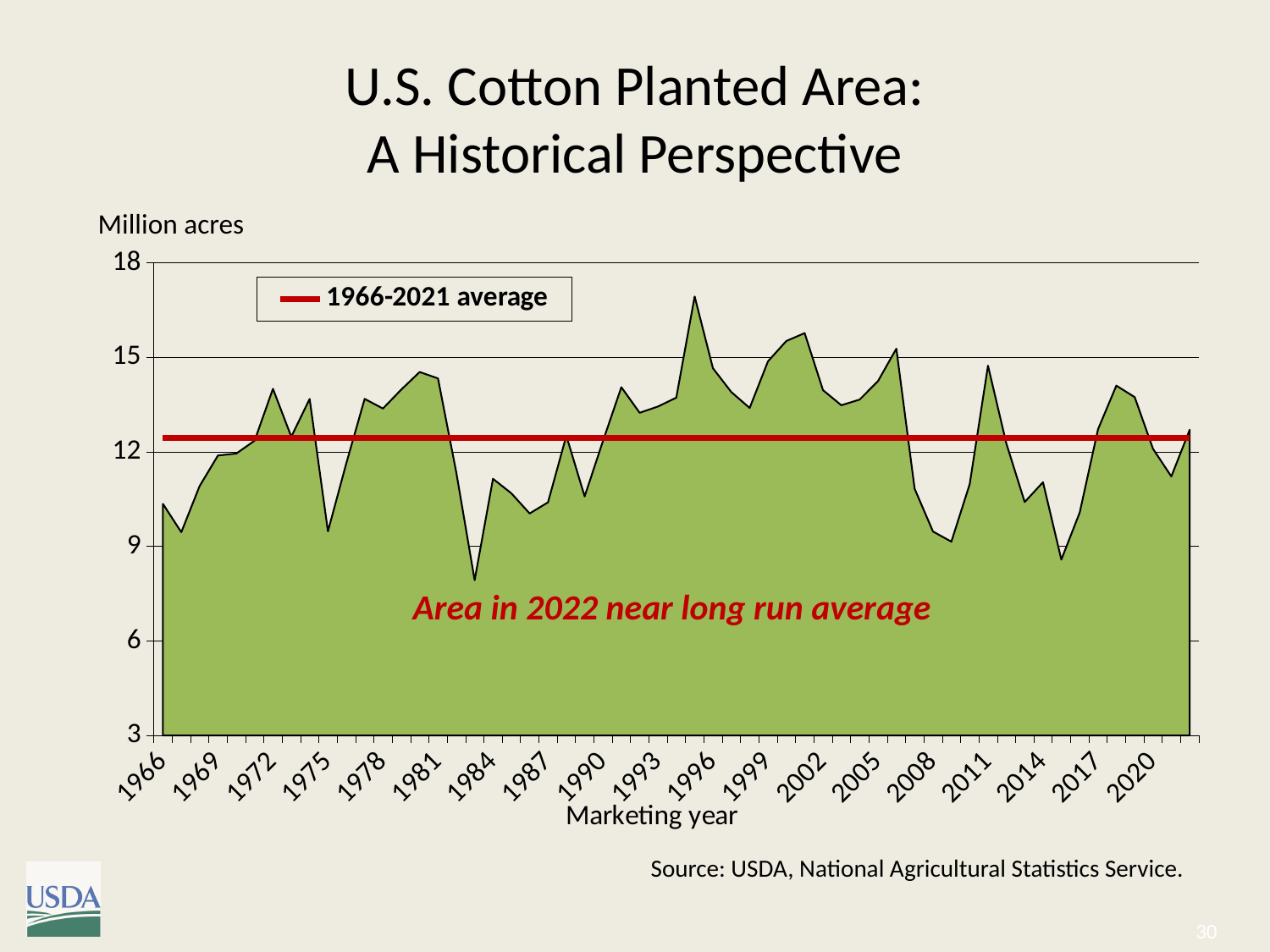
Is the planted area for 2011 greater or less than 12 million acres? greater Is the planted area for 1987 greater or less than 12 million acres? less Is the planted area for 2008 greater or less than 12 million acres? less Does the planted area rise or fall from 2011 to 2014? fall Does the planted area rise or fall from 2008 to 2011? rise What unit is shown above the vertical axis of the chart? Million acres What kind of chart is shown on the slide? Area chart What entry does the chart legend list? 1966-2021 average How many entries does the chart legend list? 1